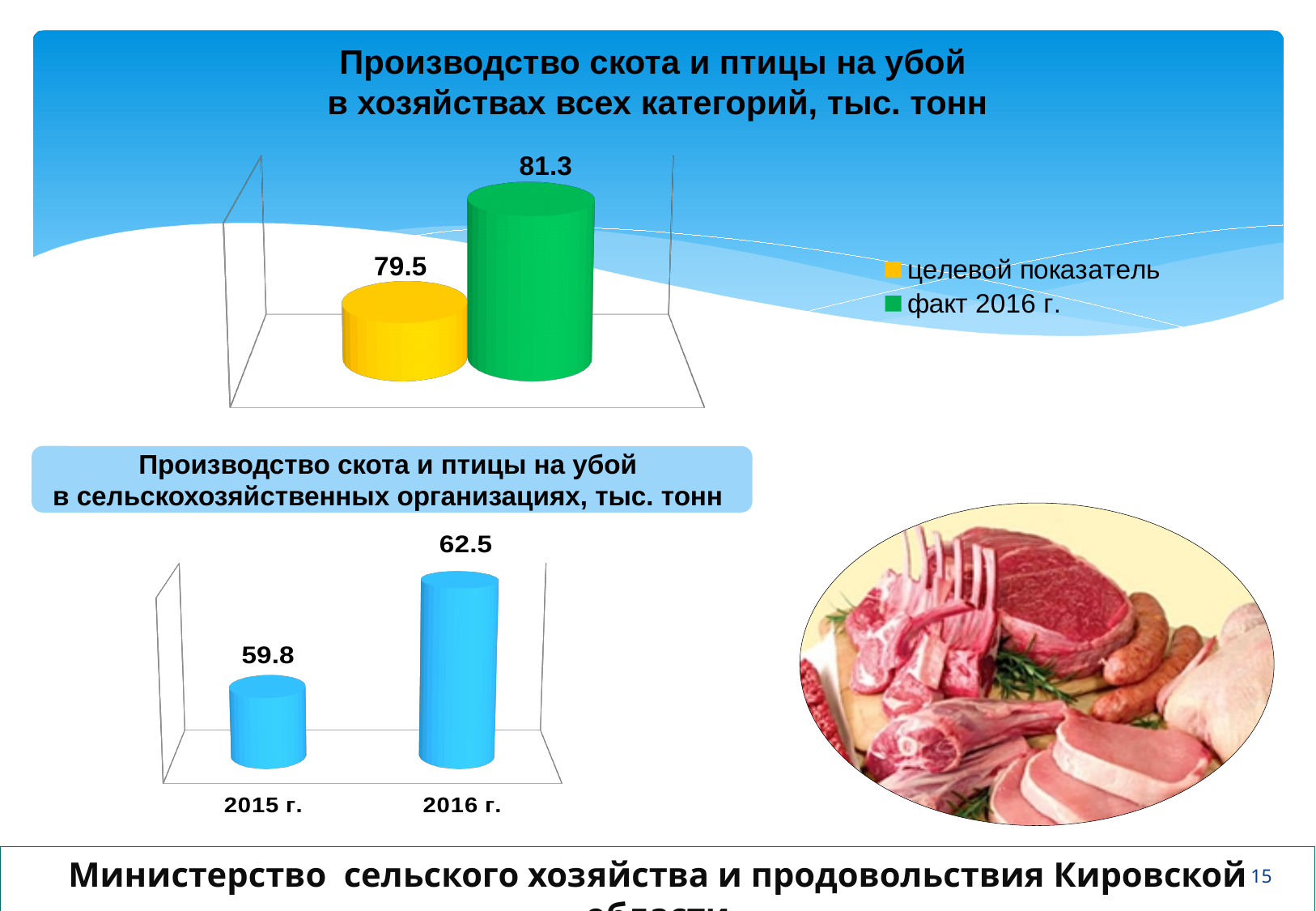
In the top chart (Производство скота и птицы на убой в хозяйствах всех категорий), what is the value for целевой показатель? 79.5 What kind of chart is the bottom chart (Производство скота и птицы на убой в сельскохозяйственных организациях)? Bar chart In the top chart (Производство скота и птицы на убой в хозяйствах всех категорий), what is the value for факт 2016 г.? 81.3 In the top chart (Производство скота и птицы на убой в хозяйствах всех категорий), how many series does the legend list? 2 In the bottom chart (Производство скота и птицы на убой в сельскохозяйственных организациях), which year has the lower value? 2015 г. In the top chart (Производство скота и птицы на убой в хозяйствах всех категорий), which series has the higher value? факт 2016 г. In the bottom chart (Производство скота и птицы на убой в сельскохозяйственных организациях), what is the value for 2016 г.? 62.5 In the bottom chart (Производство скота и птицы на убой в сельскохозяйственных организациях), do the values rise or fall from 2015 г. to 2016 г.? Rise In the top chart (Производство скота и птицы на убой в хозяйствах всех категорий), what colour is the bar for целевой показатель? Yellow In the bottom chart (Производство скота и птицы на убой в сельскохозяйственных организациях), by how much did the value increase from 2015 г. to 2016 г.? 2.7 In the top chart (Производство скота и птицы на убой в хозяйствах всех категорий), what is the difference between факт 2016 г. and целевой показатель? 1.8 In the bottom chart (Производство скота и птицы на убой в сельскохозяйственных организациях), what is the value for 2015 г.? 59.8